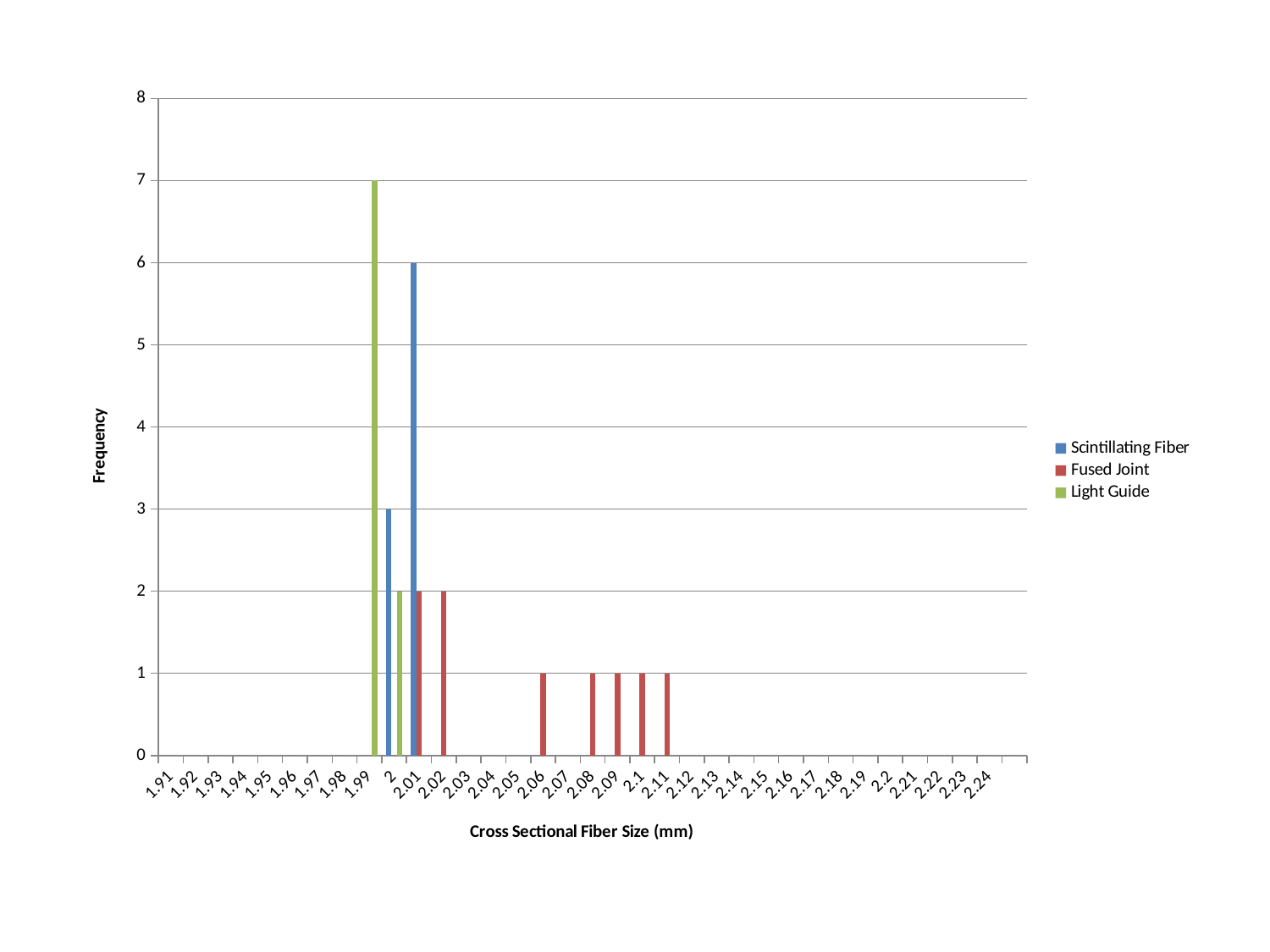
What is the label of the x axis? Cross Sectional Fiber Size (mm) Which series is shown in red? Fused Joint What is the frequency of Fused Joint at 2.02 mm? 2 Which is larger: the Scintillating Fiber frequency at 2 mm or the Light Guide frequency at 2 mm? Scintillating Fiber What is the frequency of Scintillating Fiber at 2 mm? 3 How many series does the legend list? 3 How many fiber sizes have a Fused Joint frequency of 1? 5 What kind of chart is shown on the slide? bar chart What is the frequency of Light Guide at 1.99 mm? 7 What is the difference between the Light Guide frequency at 1.99 mm and the Scintillating Fiber frequency at 2.01 mm? 1 At which fiber size does Light Guide reach its highest frequency? 1.99 What is the frequency of Scintillating Fiber at 2.01 mm? 6